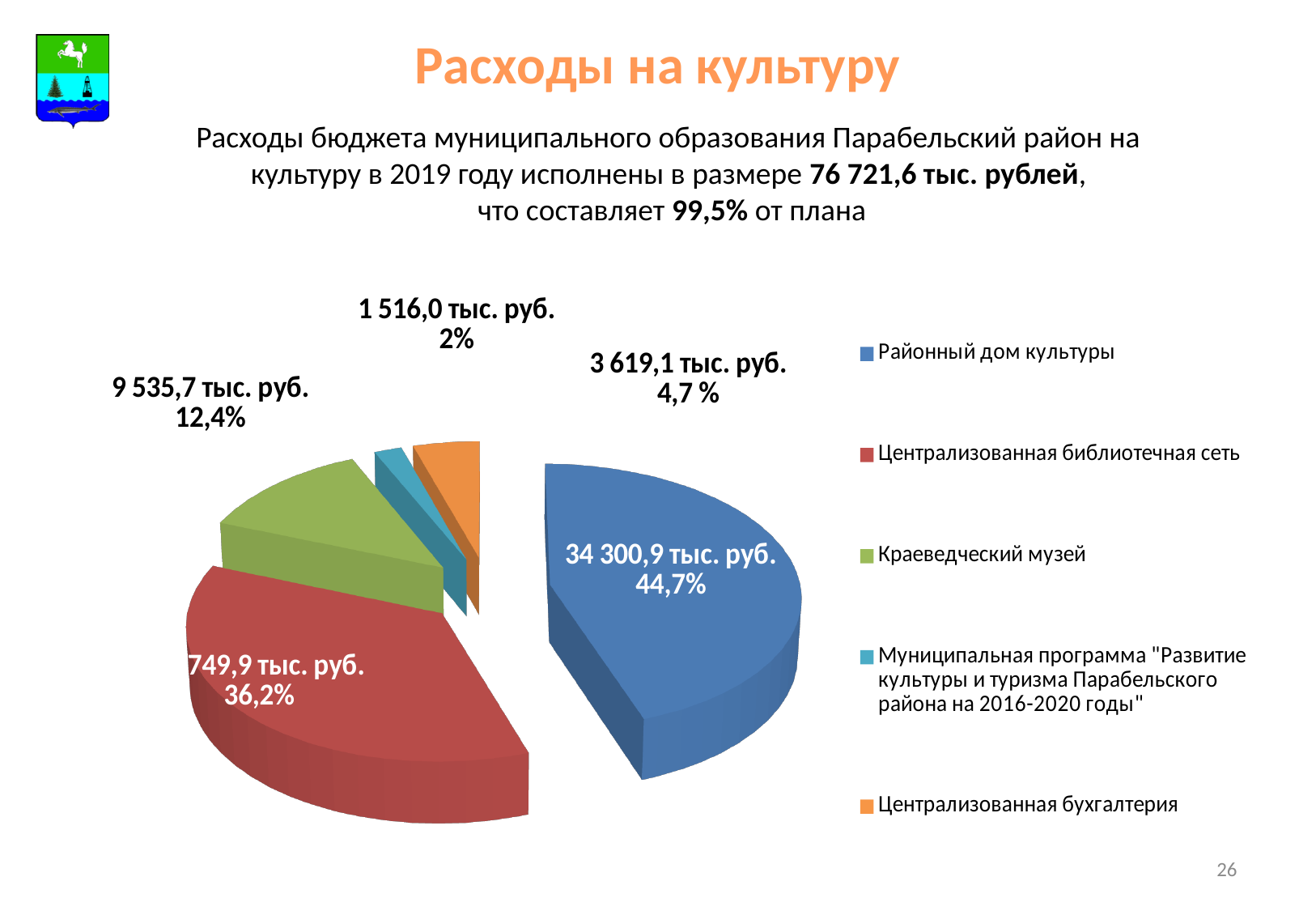
What is the value shown for Краеведческий музей? 9 535,7 тыс. руб. What share of the pie does the Муниципальная программа "Развитие культуры и туризма Парабельского района на 2016-2020 годы" have? 2% How many slices does the pie chart have? 5 Which category has the largest slice of the pie? Районный дом культуры What is the value shown for Централизованная бухгалтерия? 3 619,1 тыс. руб. What share of the pie does Районный дом культуры have? 44,7% Which category has the smallest slice of the pie? Муниципальная программа "Развитие культуры и туризма Парабельского района на 2016-2020 годы" What share of the pie does Централизованная библиотечная сеть have? 36,2% What kind of chart is shown on the slide? pie chart How many entries does the legend of the pie chart list? 5 What is the value shown for Районный дом культуры? 34 300,9 тыс. руб.